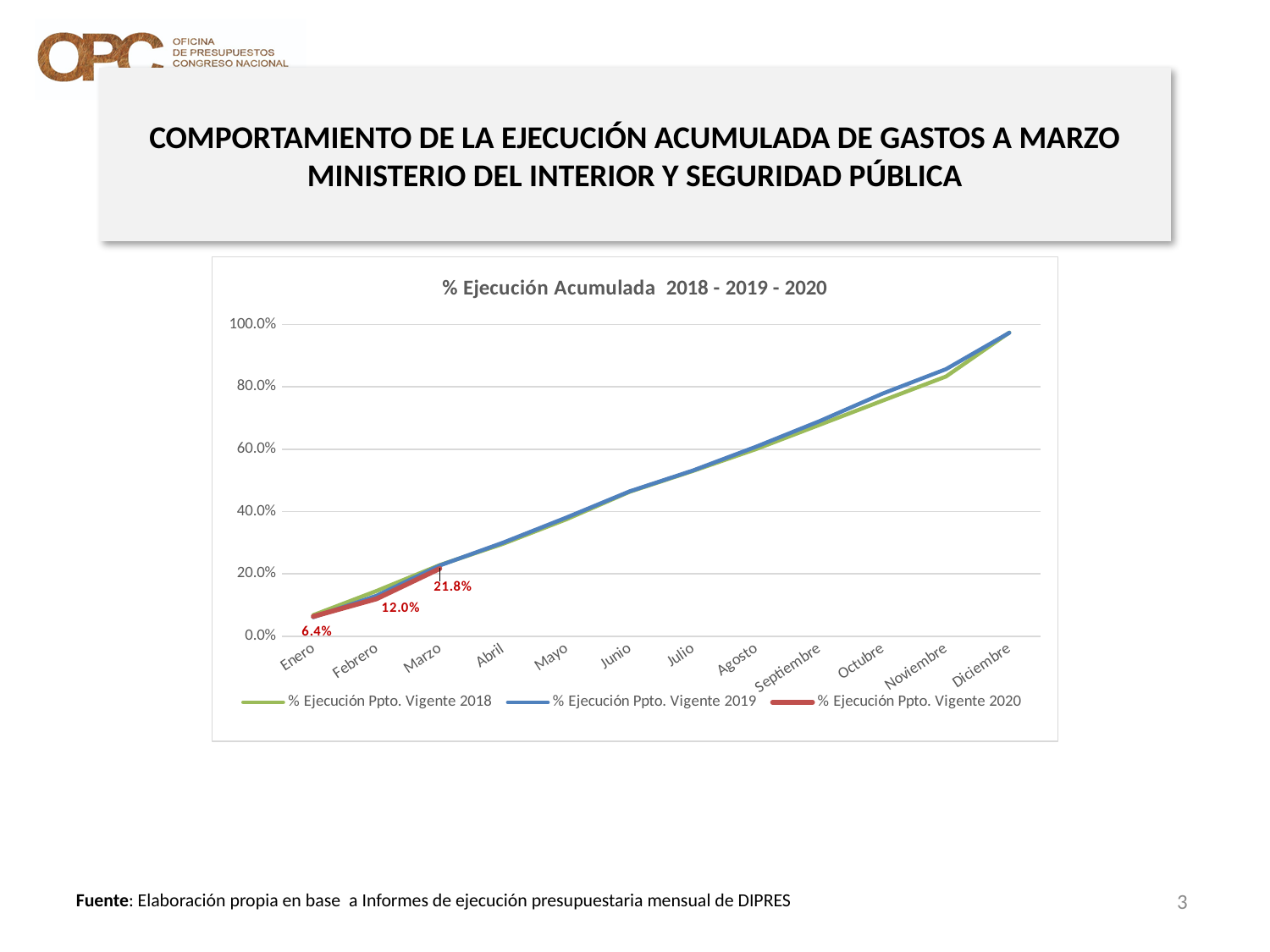
What is the value for % Ejecución Ppto. Vigente 2020 in Febrero? 12.0% Which month has the highest value for the % Ejecución Ppto. Vigente 2020 series? Marzo What is the title of the chart? % Ejecución Acumulada 2018 - 2019 - 2020 How many months are shown along the x axis? 12 By how much did % Ejecución Ppto. Vigente 2020 increase from Enero to Febrero? 5.6% Do the values for % Ejecución Ppto. Vigente 2019 rise or fall from Enero to Diciembre? rise What is the value for % Ejecución Ppto. Vigente 2020 in Enero? 6.4% How many series does the legend list? 3 Is the value for % Ejecución Ppto. Vigente 2019 in Diciembre greater or less than 80.0%? greater What is the value for % Ejecución Ppto. Vigente 2020 in Marzo? 21.8% What kind of chart is shown on the slide? line chart By how much did % Ejecución Ppto. Vigente 2020 increase from Febrero to Marzo? 9.8%